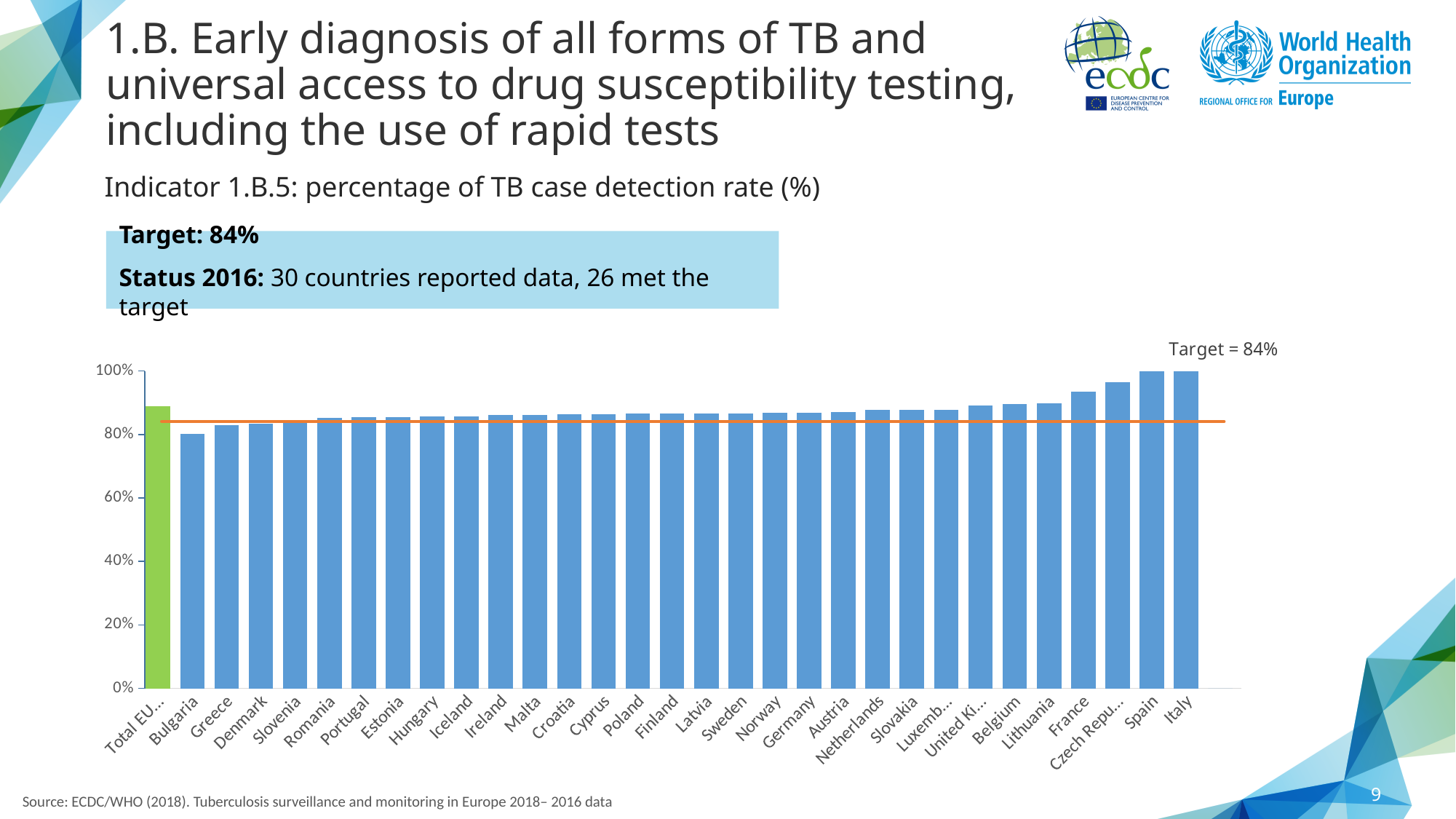
Which is larger, the value for Greece or the value for Lithuania? Lithuania Which category has the lowest TB case detection rate in the chart? Bulgaria Is the value for France greater or less than 80%? greater What target value is marked by the horizontal line on the chart? 84% Do the country values generally rise or fall moving from Bulgaria to Italy along the x axis? rise Which is larger, the value for Spain or the value for Bulgaria? Spain Is the value for Greece greater or less than 90%? less What kind of chart is shown on the slide? bar chart How many bars are plotted in the chart? 31 What colour is the bar for Total EU, which differs from the other bars? green Is the value for Bulgaria greater or less than 84%? less